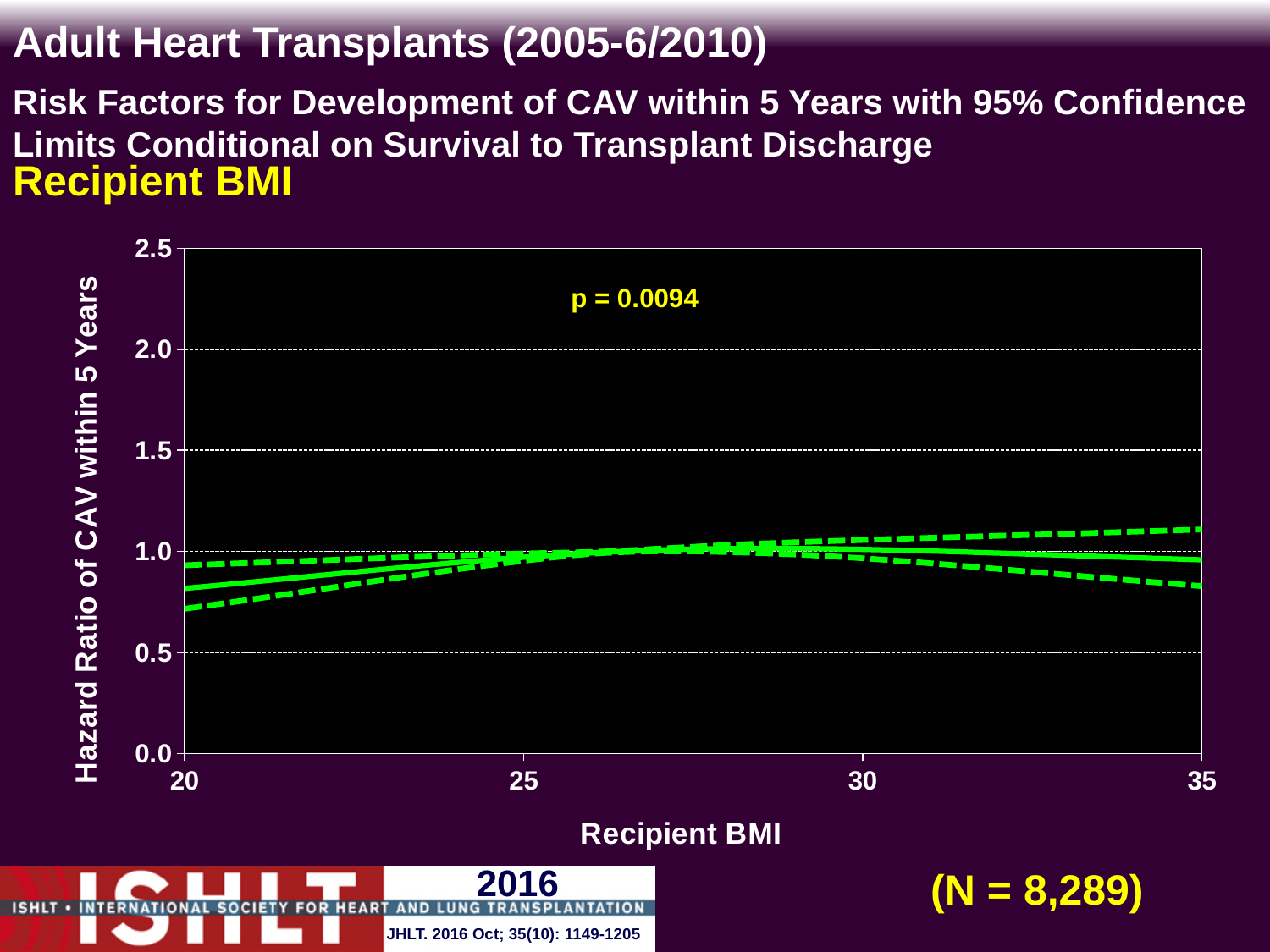
What is the label of the x axis of the chart? Recipient BMI What kind of chart is shown on the slide? line chart How many lines are plotted on the chart (including the confidence limits)? 3 Is the lower 95% confidence limit at a recipient BMI of 20 greater or less than 1.0? less Is the upper 95% confidence limit at a recipient BMI of 35 greater or less than 1.0? greater What is the highest value labelled on the y axis of the chart? 2.5 What p-value is printed on the chart? p = 0.0094 What is the label of the y axis of the chart? Hazard Ratio of CAV within 5 Years How many tick values are labelled on the x axis of the chart? 4 Is the hazard ratio (solid line) at a recipient BMI of 20 greater or less than 1.0? less Does the hazard ratio rise or fall as recipient BMI increases from 20 to 25? rise What is the sample size (N) shown on the slide? 8,289